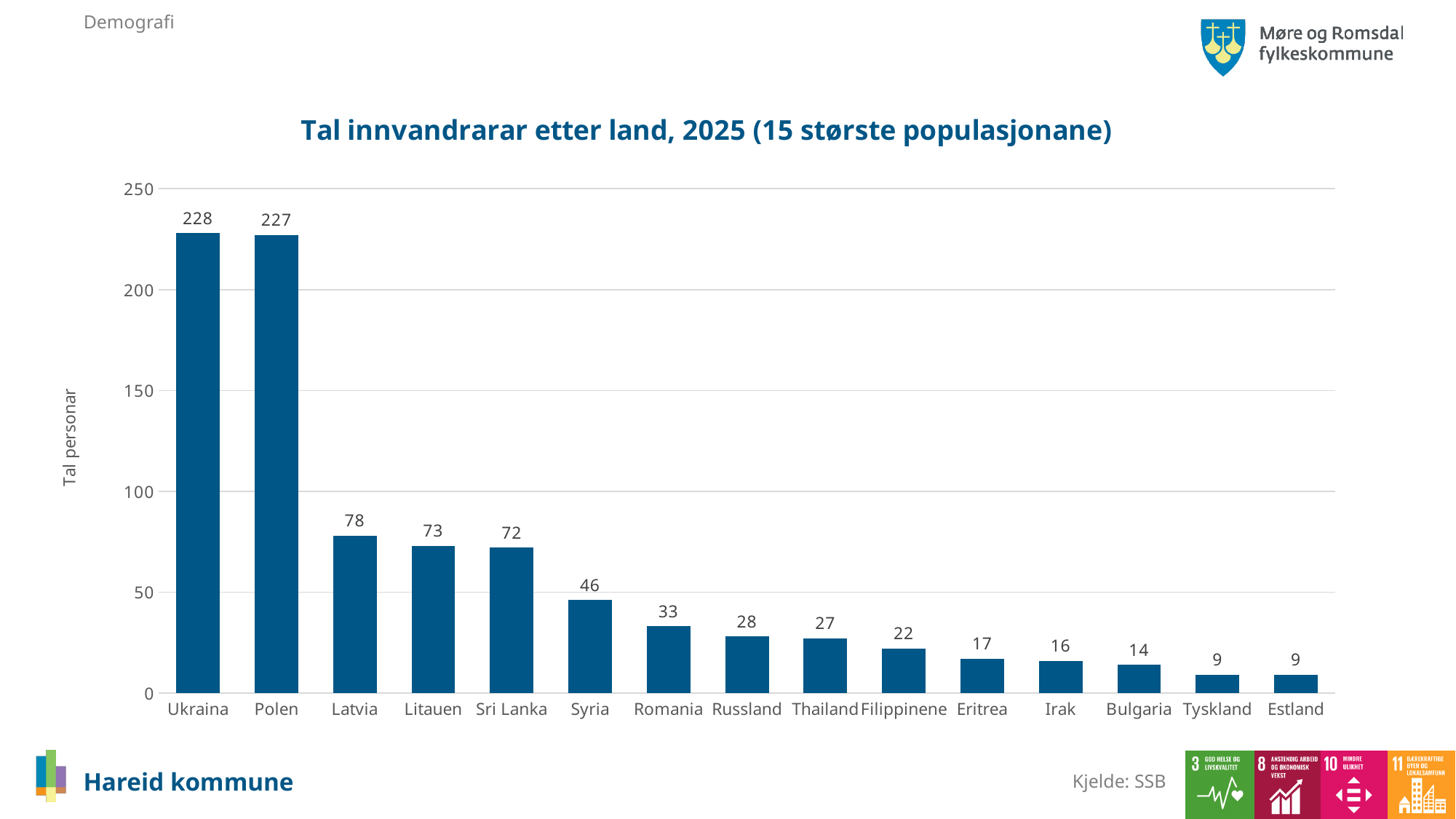
What is the difference between the values for Latvia and Litauen? 5 What kind of chart is shown on the slide? bar chart How many countries are shown on the x axis? 15 What is the value for Filippinene? 22 Do the values rise or fall from left to right along the x axis? fall What is the value for Sri Lanka? 72 What is the title of the chart? Tal innvandrarar etter land, 2025 (15 største populasjonane) Is the value for Latvia greater or less than 100? less What is the value for Ukraina? 228 Which country has the highest value? Ukraina What is the difference between the values for Ukraina and Polen? 1 Which is larger, the value for Syria or the value for Romania? Syria